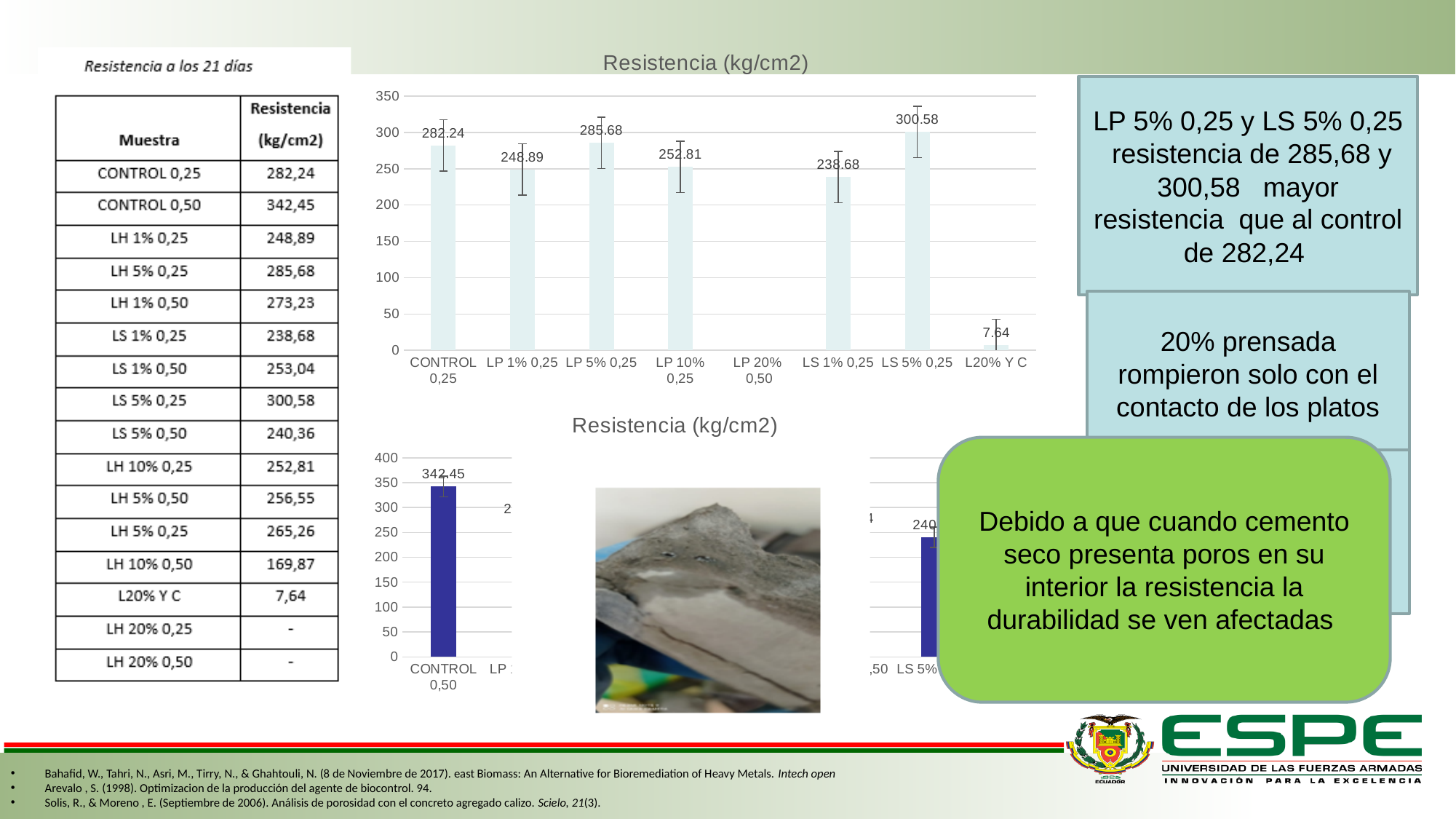
What kind of chart is the top chart? bar chart In the bottom chart, what is the value for CONTROL 0,50? 342.45 In the top chart, which is larger, LP 5% 0,25 or LP 1% 0,25? LP 5% 0,25 In the top chart, which category has the highest value? LS 5% 0,25 In the top chart, what is the value for L20% Y C? 7.64 In the top chart, what is the value for CONTROL 0,25? 282.24 In the top chart, which category has the lowest plotted value? L20% Y C In the top chart, what is the value for LP 10% 0,25? 252.81 In the top chart, is the value for LS 1% 0,25 greater or less than 250? less In the top chart, what is the difference between LS 5% 0,25 and CONTROL 0,25? 18.34 How many category labels are shown on the x axis of the top chart? 8 In the top chart, what is the value for LS 5% 0,25? 300.58